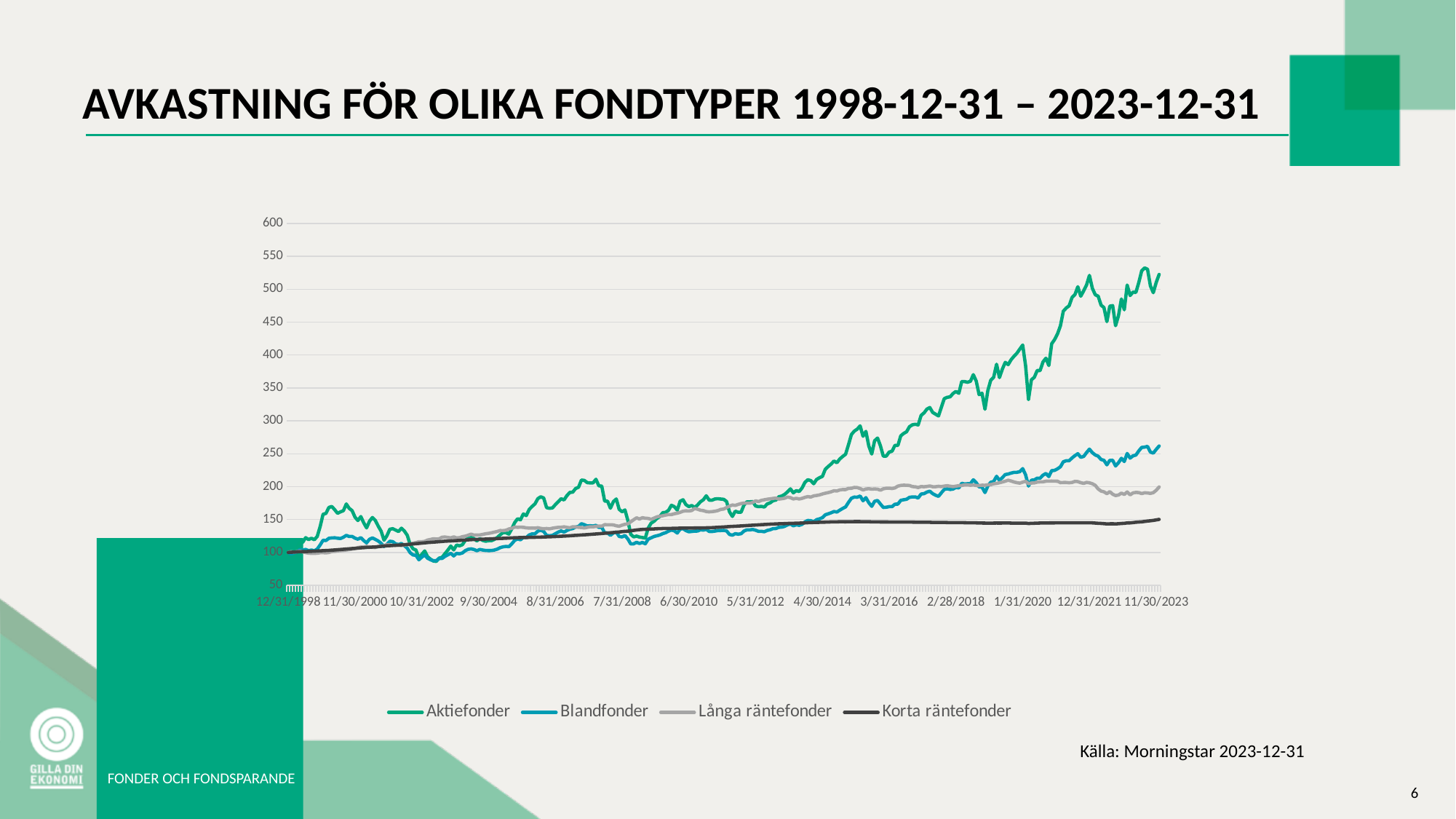
What is the title of the chart on the slide? AVKASTNING FÖR OLIKA FONDTYPER 1998-12-31 – 2023-12-31 How many series does the legend list? 4 Which series is drawn in green in the chart? Aktiefonder Is the value for Aktiefonder at the end of the period greater or less than 500? greater Is the value for Blandfonder at the end of the period greater or less than 200? greater Does the Korta räntefonder line generally rise or fall over the period shown? rise What is the highest value shown on the vertical axis? 600 Which series has the highest value at the end of the period (11/30/2023)? Aktiefonder Is the value for Korta räntefonder at the end of the period greater or less than 200? less What kind of chart is shown on the slide? line chart Which series has the lowest value at the end of the period (11/30/2023)? Korta räntefonder At the end of the period, which is larger: Blandfonder or Långa räntefonder? Blandfonder